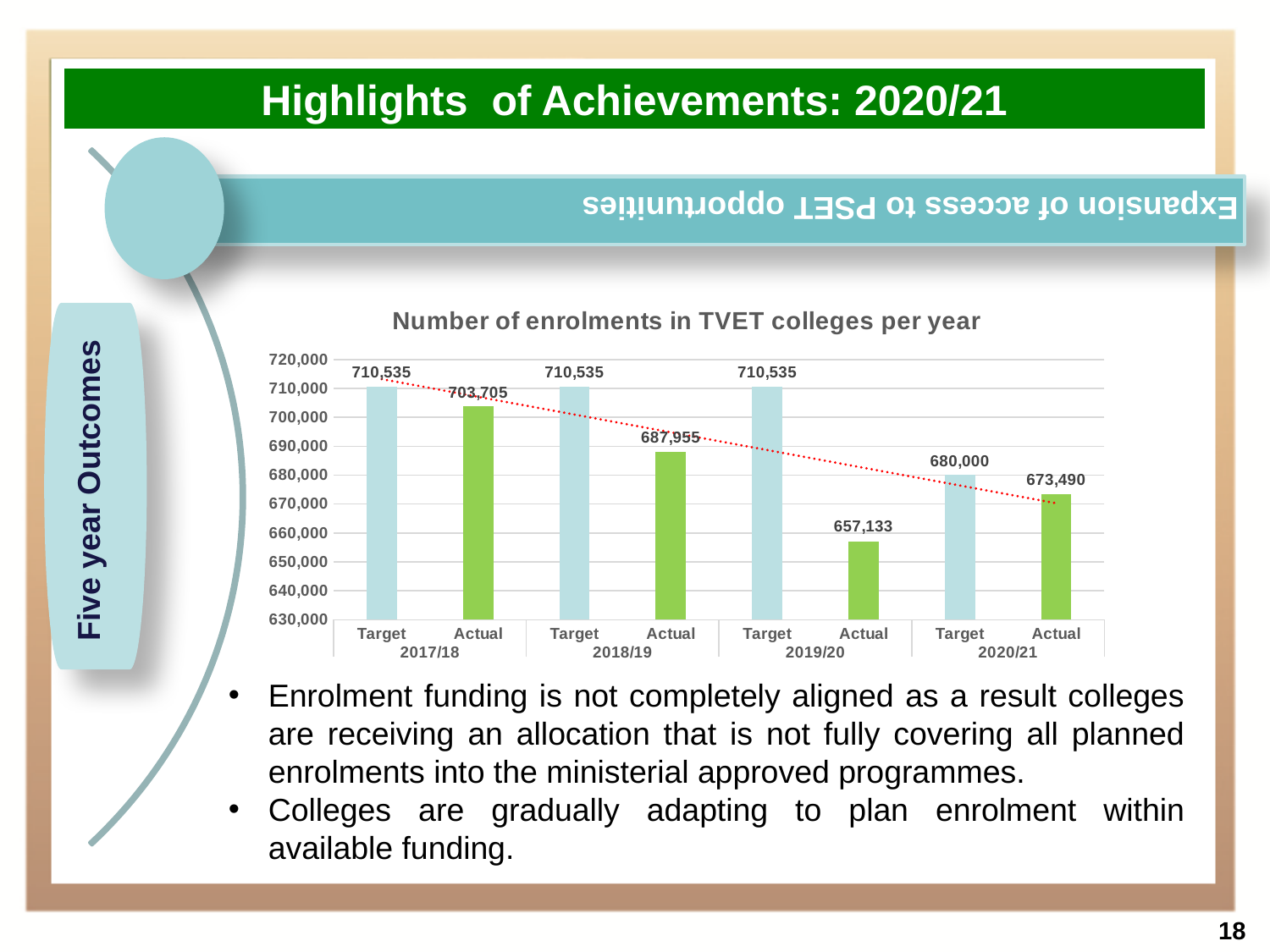
Which bar has the lowest value in the chart? Actual 2019/20 How many bars are plotted in the chart? 8 Do the Actual values rise or fall from 2017/18 to 2019/20? Fall What is the Target value for 2017/18? 710,535 What is the Target value for 2020/21? 680,000 What is the Actual value for 2018/19? 687,955 What is the difference between the Target and Actual values for 2017/18? 6,830 What is the title of the chart? Number of enrolments in TVET colleges per year What is the difference between the Target and Actual values for 2020/21? 6,510 What is the Actual value for 2019/20? 657,133 What type of chart is shown on the slide? Bar chart Which is larger, the Actual value for 2018/19 or the Actual value for 2020/21? Actual 2018/19